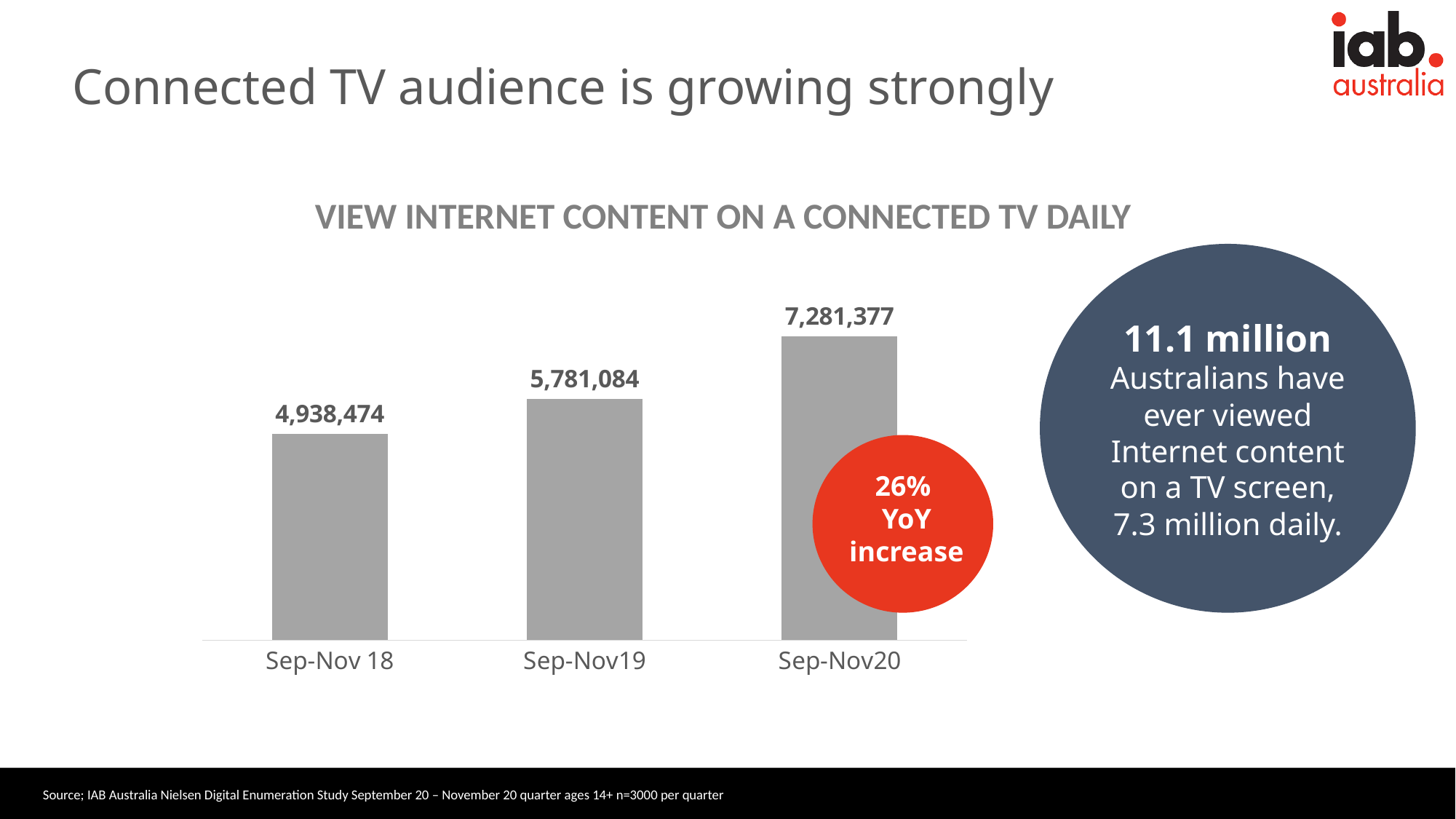
What kind of chart is shown on the slide? Bar chart Which is larger, the value for Sep-Nov19 or Sep-Nov 18? Sep-Nov19 How many periods are shown in the chart? 3 What is the value for Sep-Nov 18? 4,938,474 What is the difference between the Sep-Nov19 and Sep-Nov 18 values? 842,610 What is the value for Sep-Nov19? 5,781,084 Do the values rise or fall from Sep-Nov 18 to Sep-Nov20? Rise What is the difference between the Sep-Nov20 and Sep-Nov19 values? 1,500,293 What is the value for Sep-Nov20? 7,281,377 Which period has the highest value? Sep-Nov20 Which period has the lowest value? Sep-Nov 18 What is the title of the chart? VIEW INTERNET CONTENT ON A CONNECTED TV DAILY